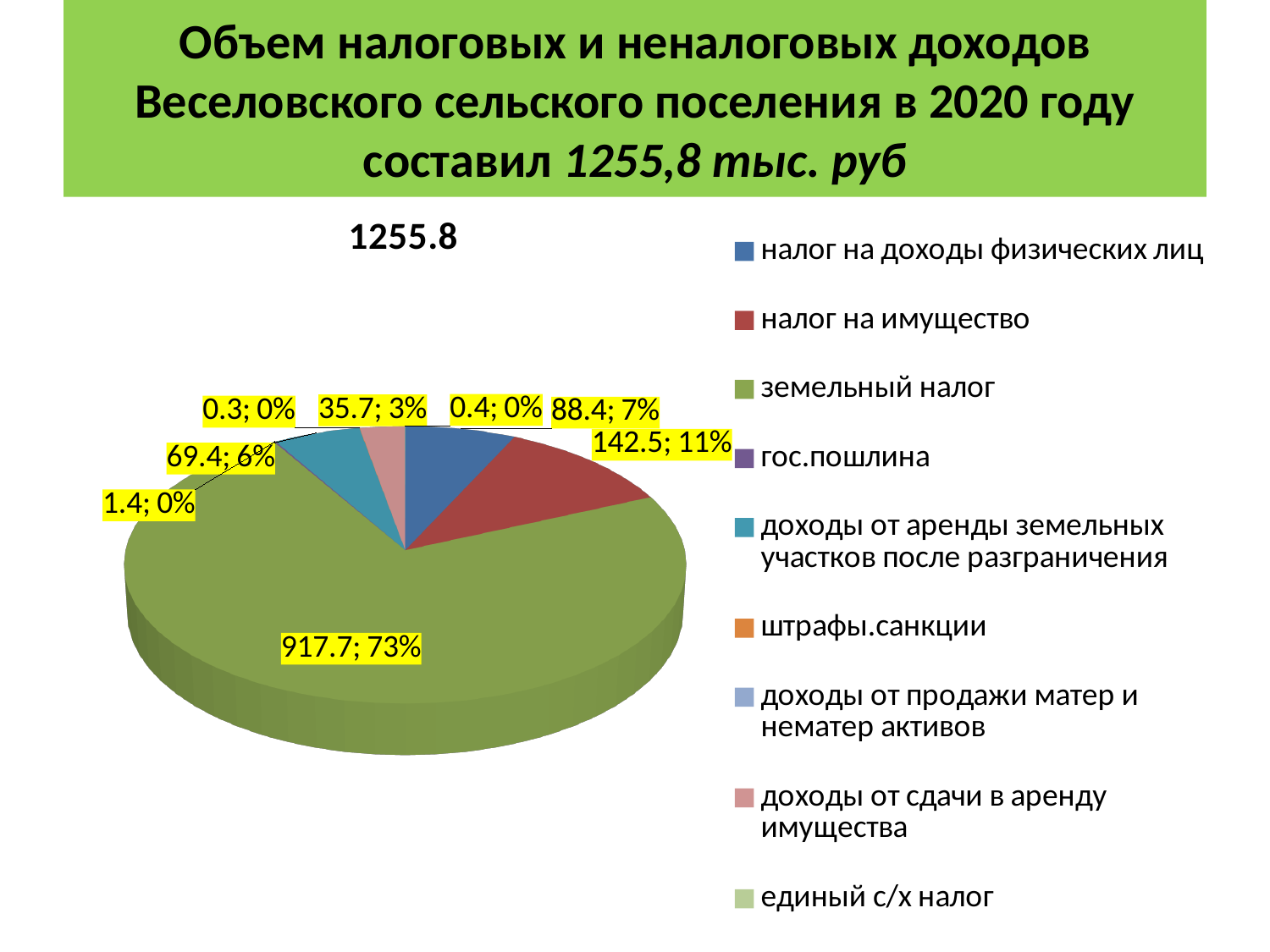
What value is labelled on the slice for доходы от аренды земельных участков после разграничения? 69.4 How many entries does the legend of the pie chart list? 9 Which is larger, налог на имущество or налог на доходы физических лиц? налог на имущество What value is labelled on the slice for налог на имущество? 142.5 What is the difference between the values for земельный налог and налог на имущество? 775.2 What value is labelled on the slice for земельный налог? 917.7 What is the title shown above the pie chart? 1255.8 What share of the pie does доходы от сдачи в аренду имущества account for? 3% What share of the pie does земельный налог account for? 73% What share of the pie does налог на доходы физических лиц account for? 7% Which category has the largest slice of the pie chart? земельный налог What kind of chart is shown on the slide? pie chart